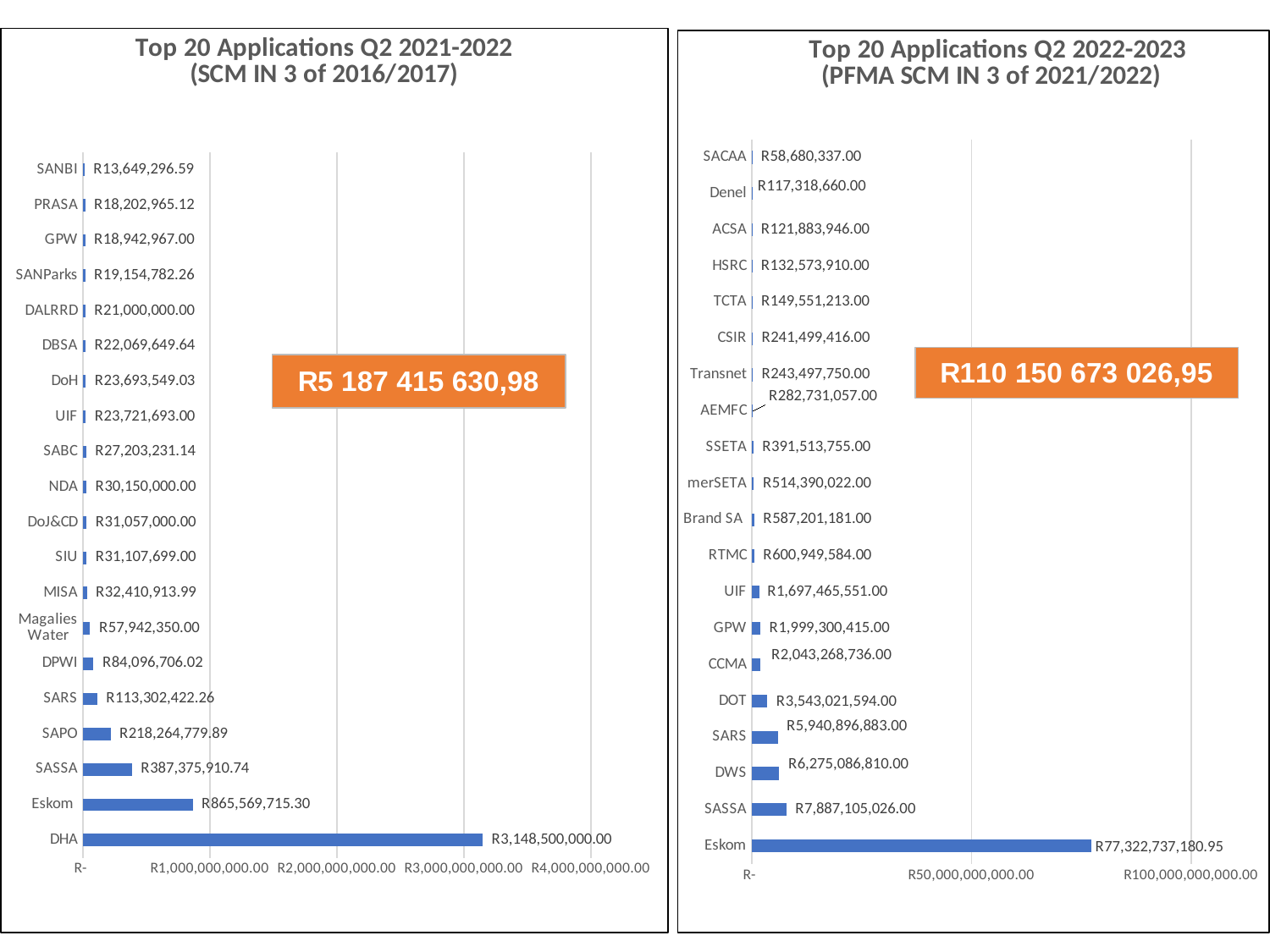
In the 'Top 20 Applications Q2 2021-2022' chart, which category has the highest value? DHA In the 'Top 20 Applications Q2 2022-2023' chart, which is larger, the value for DWS or the value for SARS? DWS In the 'Top 20 Applications Q2 2021-2022' chart, what is the value for SASSA? R387,375,910.74 In the 'Top 20 Applications Q2 2021-2022' chart, how many categories are plotted? 20 In the 'Top 20 Applications Q2 2022-2023' chart, what is the value for Eskom? R77,322,737,180.95 In the 'Top 20 Applications Q2 2022-2023' chart, which category has the lowest value? SACAA In the 'Top 20 Applications Q2 2021-2022' chart, which category has the lowest value? SANBI In the 'Top 20 Applications Q2 2022-2023' chart, is the value for Eskom greater or less than R50,000,000,000.00? greater In the 'Top 20 Applications Q2 2022-2023' chart, what is the value for Transnet? R243,497,750.00 In the 'Top 20 Applications Q2 2021-2022' chart, which is larger, the value for SAPO or the value for SARS? SAPO In the 'Top 20 Applications Q2 2021-2022' chart, what is the value for DHA? R3,148,500,000.00 What type of chart is the 'Top 20 Applications Q2 2022-2023' chart? bar chart